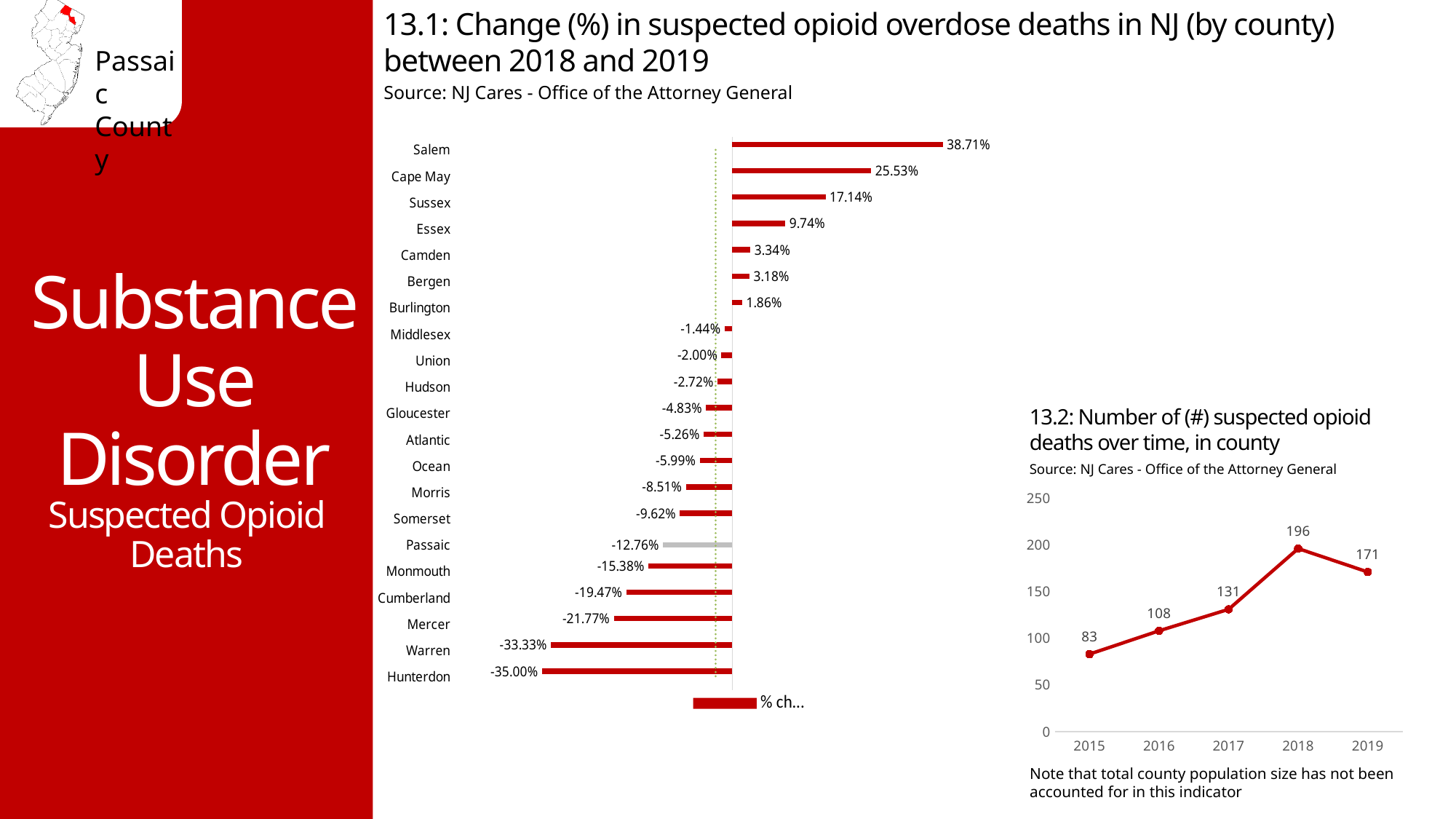
In chart 13.2, what is the difference in suspected opioid deaths between 2018 and 2019? 25 In chart 13.1, how many counties are shown? 21 In chart 13.1, what is the change (%) in suspected opioid overdose deaths for Passaic? -12.76% In chart 13.1, which has a larger change (%): Sussex or Essex? Sussex In chart 13.2, how many suspected opioid deaths were there in 2018? 196 In chart 13.1, which county has the lowest change (%) in suspected opioid overdose deaths? Hunterdon What kind of chart is chart 13.2? Line chart In chart 13.2, which year has the lowest number of suspected opioid deaths? 2015 In chart 13.1, which county has the highest change (%) in suspected opioid overdose deaths? Salem In chart 13.1, what is the value shown for Cape May? 25.53% What kind of chart is chart 13.1? Bar chart In chart 13.2, how many data points are plotted? 5